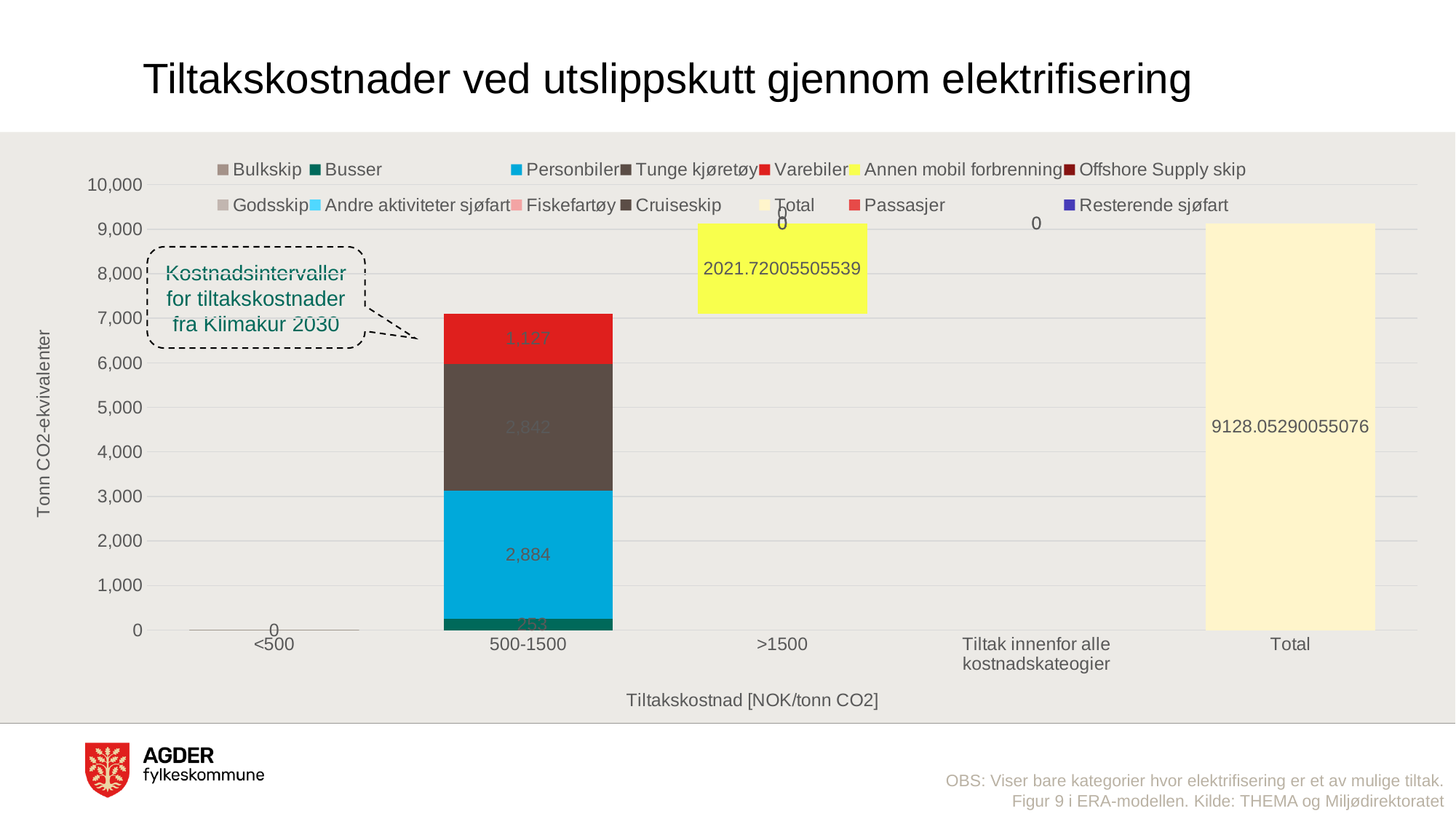
What kind of chart is shown on the slide? Stacked bar chart Which segment is the smallest in the 500-1500 bar? Busser In the 500-1500 bar, which is larger: the Personbiler segment or the Varebiler segment? Personbiler What is the value of the Personbiler segment in the 500-1500 bar? 2,884 What is the value of the Varebiler segment in the 500-1500 bar? 1,127 What is the difference between the Personbiler and Tunge kjøretøy segments in the 500-1500 bar? 42 What is the value of the Annen mobil forbrenning segment in the >1500 bar? 2021.72005505539 What is the total of the stacked 500-1500 bar? 7,106 How many series does the legend list? 14 What value is labelled on the Total bar? 9128.05290055076 How many categories are shown on the x axis? 5 What is the value of the Tunge kjøretøy segment in the 500-1500 bar? 2,842